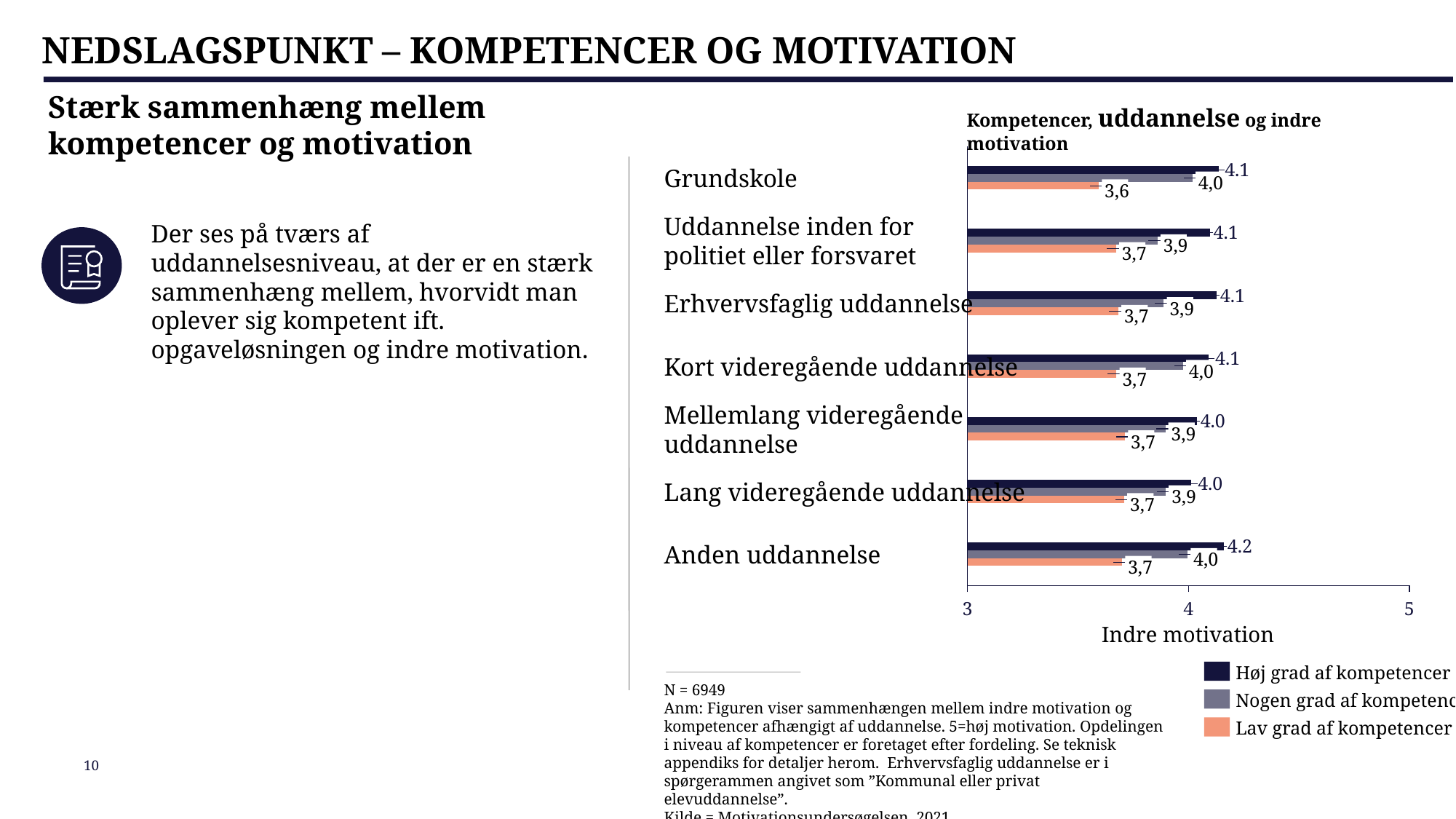
What is the value for 'Høj grad af kompetencer' for Anden uddannelse? 4.2 What is the difference between the 'Høj grad af kompetencer' and 'Lav grad af kompetencer' values for Grundskole? 0,5 How many series does the chart's legend list? 3 What is the value for 'Lav grad af kompetencer' for Grundskole? 3,6 What is the title of the chart's horizontal axis? Indre motivation Which category has the lowest value for 'Lav grad af kompetencer'? Grundskole Which category has the highest value for 'Høj grad af kompetencer'? Anden uddannelse What is the value for 'Nogen grad af kompetencer' for Kort videregående uddannelse? 4,0 How many education categories are plotted in the chart? 7 What kind of chart is shown on the slide? bar chart For Grundskole, which is larger: the value for 'Nogen grad af kompetencer' or 'Lav grad af kompetencer'? Nogen grad af kompetencer Is the value for 'Lav grad af kompetencer' for Lang videregående uddannelse greater or less than 4? less